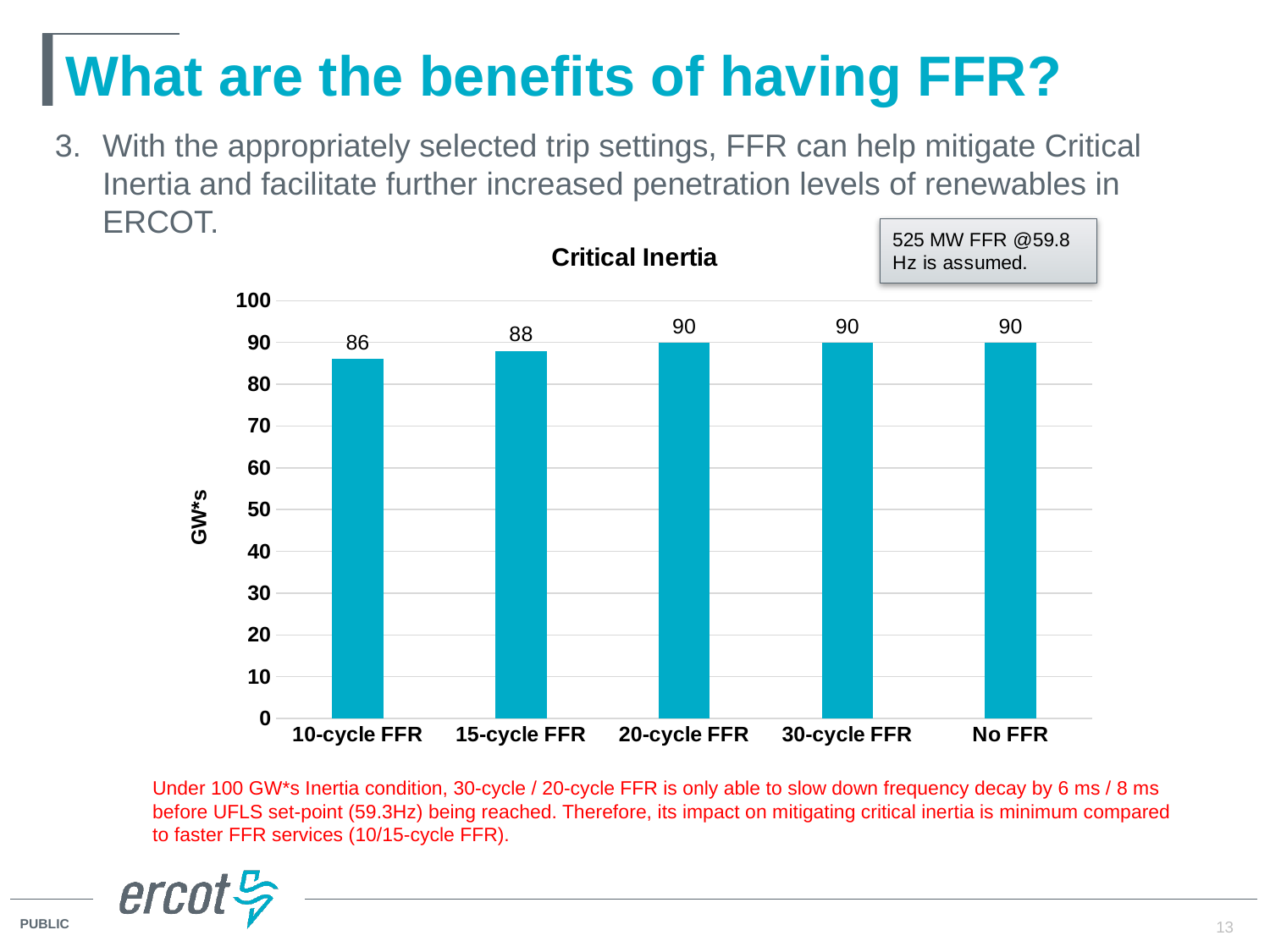
What is the difference between the Critical Inertia values for 15-cycle FFR and 10-cycle FFR? 2 What is the Critical Inertia value for 15-cycle FFR? 88 How many categories are shown on the x axis of the chart? 5 Which is larger, the Critical Inertia value for 15-cycle FFR or for 20-cycle FFR? 20-cycle FFR What is the label on the y axis of the chart? GW*s Is the value for 10-cycle FFR greater or less than 90? less What is the difference between the Critical Inertia values for No FFR and 10-cycle FFR? 4 What kind of chart is shown on the slide? bar chart What is the title of the chart? Critical Inertia What is the Critical Inertia value for 10-cycle FFR? 86 What is the Critical Inertia value for No FFR? 90 Which category has the lowest Critical Inertia value? 10-cycle FFR